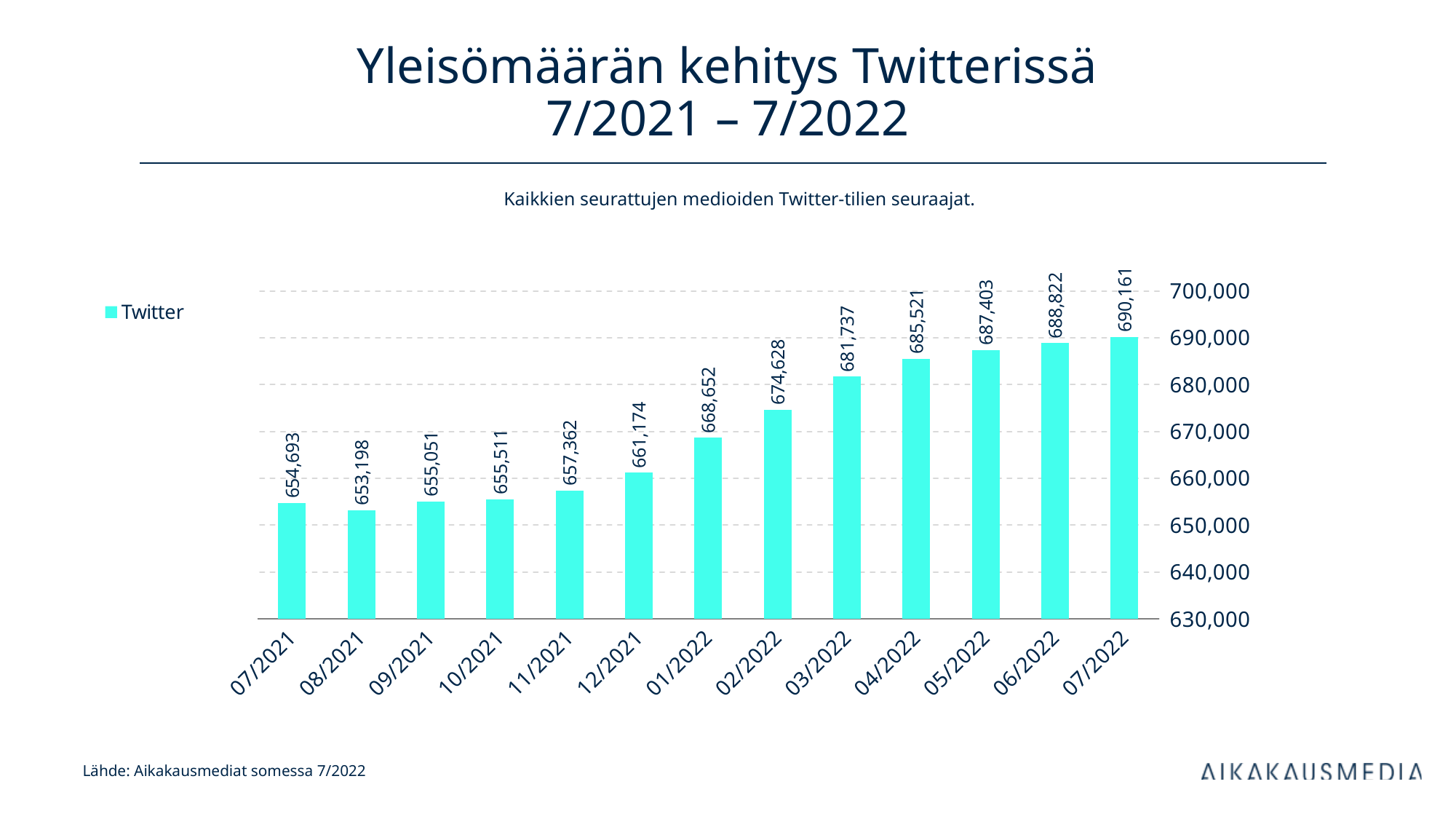
Which month has the lowest value? 08/2021 What is the value for 07/2021? 654,693 What is the difference between the values for 07/2022 and 07/2021? 35,468 What is the value for 01/2022? 668,652 What kind of chart is shown on the slide? bar chart Which month has the highest value? 07/2022 What is the difference between the values for 12/2021 and 11/2021? 3,812 How many months are shown on the x axis? 13 What is the value for 07/2022? 690,161 Do the values generally rise or fall from 08/2021 to 07/2022? rise Is the value for 04/2022 greater or less than 680,000? greater Which is larger, the value for 03/2022 or the value for 02/2022? 03/2022